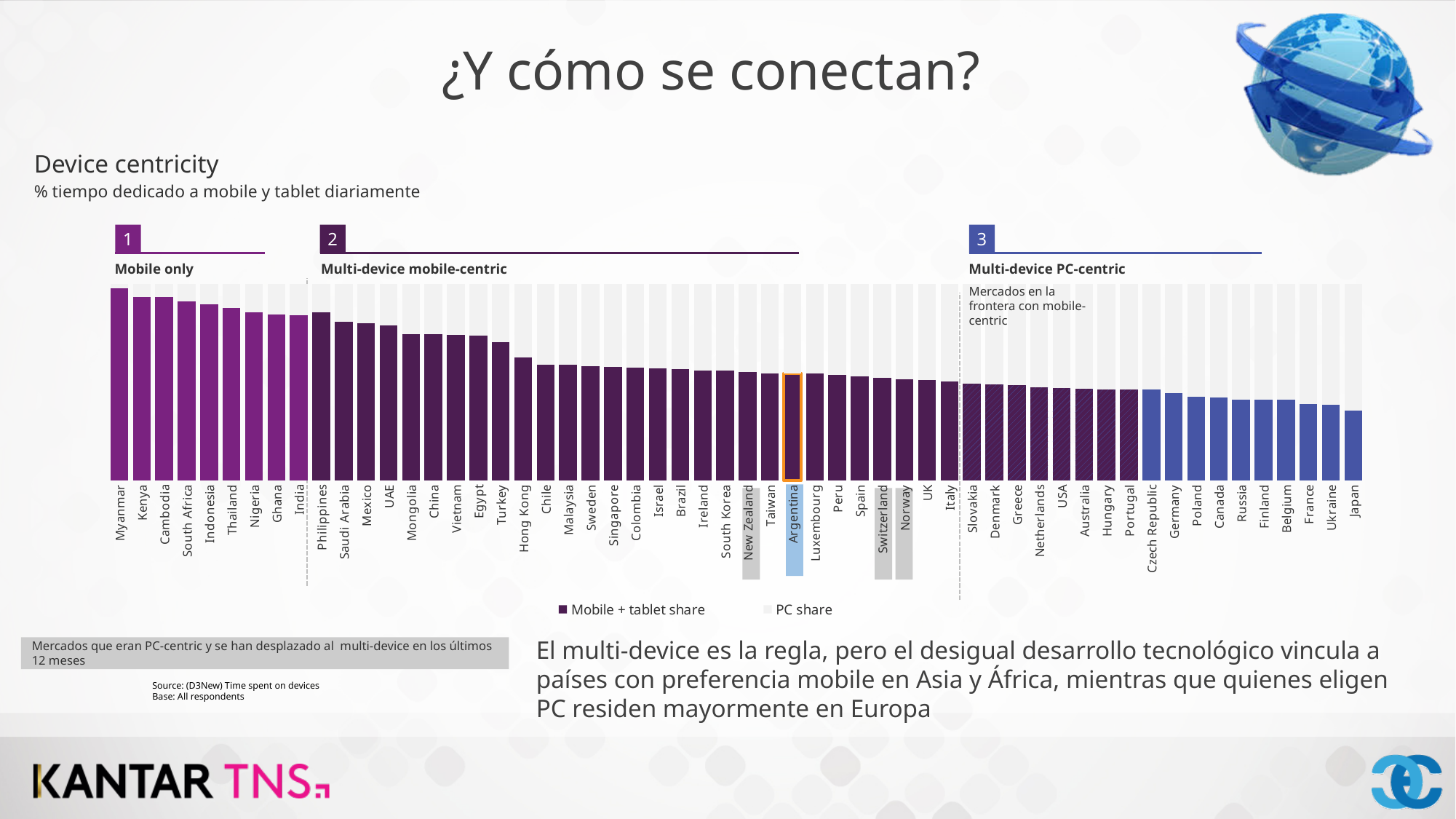
How many countries are in the 'Mobile only' group? 9 How many series does the legend list? 2 Which country's bar is highlighted with an orange outline? Argentina Which country has the highest mobile + tablet share? Myanmar How many countries are in the 'Multi-device PC-centric' group? 18 Do the mobile + tablet share values rise or fall from left to right along the x axis? fall What is the title of the chart? Device centricity Which country has the lowest mobile + tablet share? Japan Which has a larger mobile + tablet share, Japan or Slovakia? Slovakia What kind of chart is shown on the slide? bar chart Which has a larger mobile + tablet share, Philippines or Italy? Philippines Which has a larger mobile + tablet share, Kenya or Hong Kong? Kenya